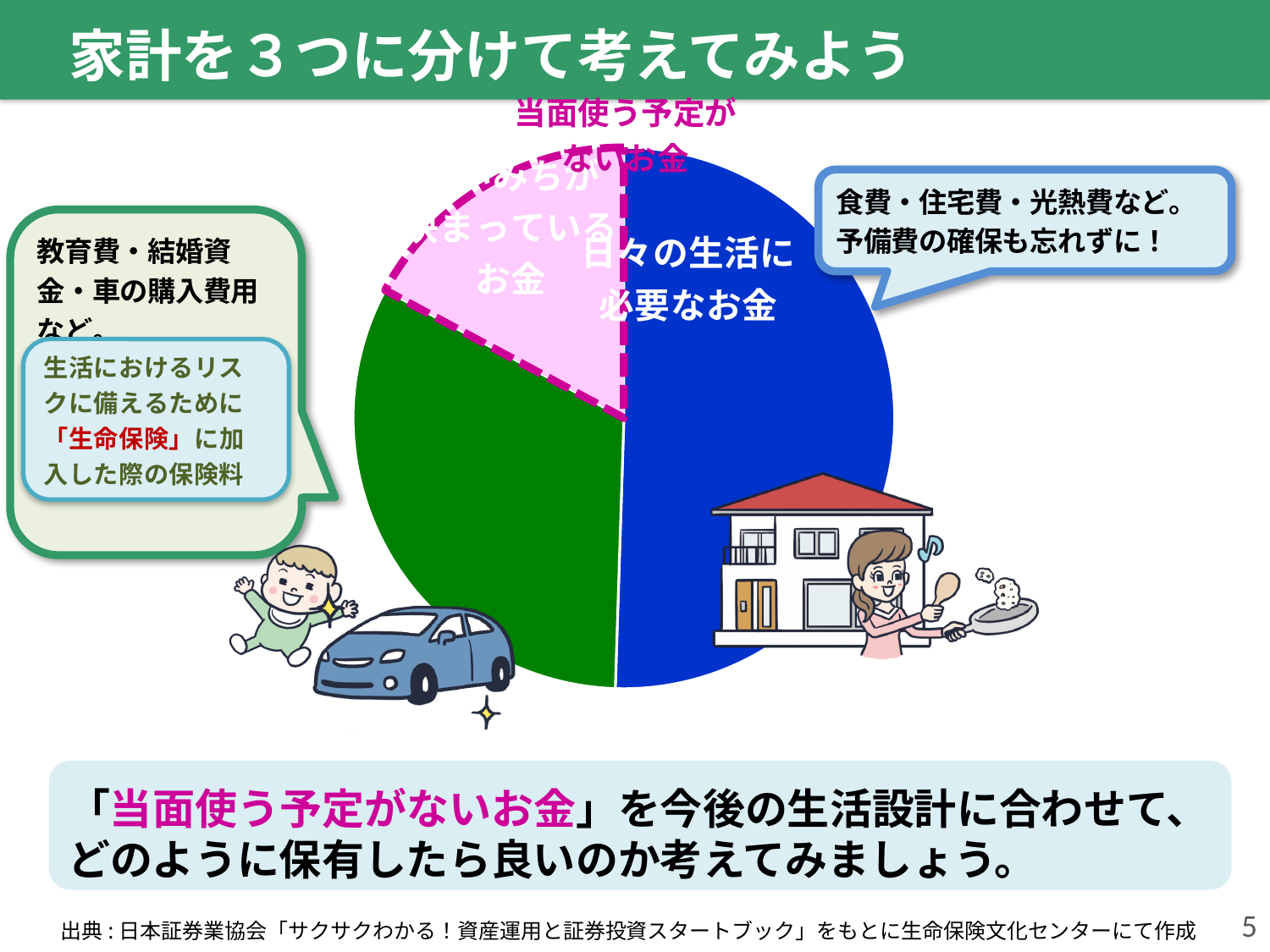
What kind of chart is shown on the slide? pie chart What colour is the slice for 日々の生活に必要なお金? blue Is the slice for 当面使う予定がないお金 larger or smaller than the green slice? smaller What colour is the slice for 当面使う予定がないお金? pink Which slice of the pie chart is the largest? 日々の生活に必要なお金 Which slice is larger: 日々の生活に必要なお金 or 当面使う予定がないお金? 日々の生活に必要なお金 Which slice of the pie chart is the smallest? 当面使う予定がないお金 How many slices does the pie chart have? 3